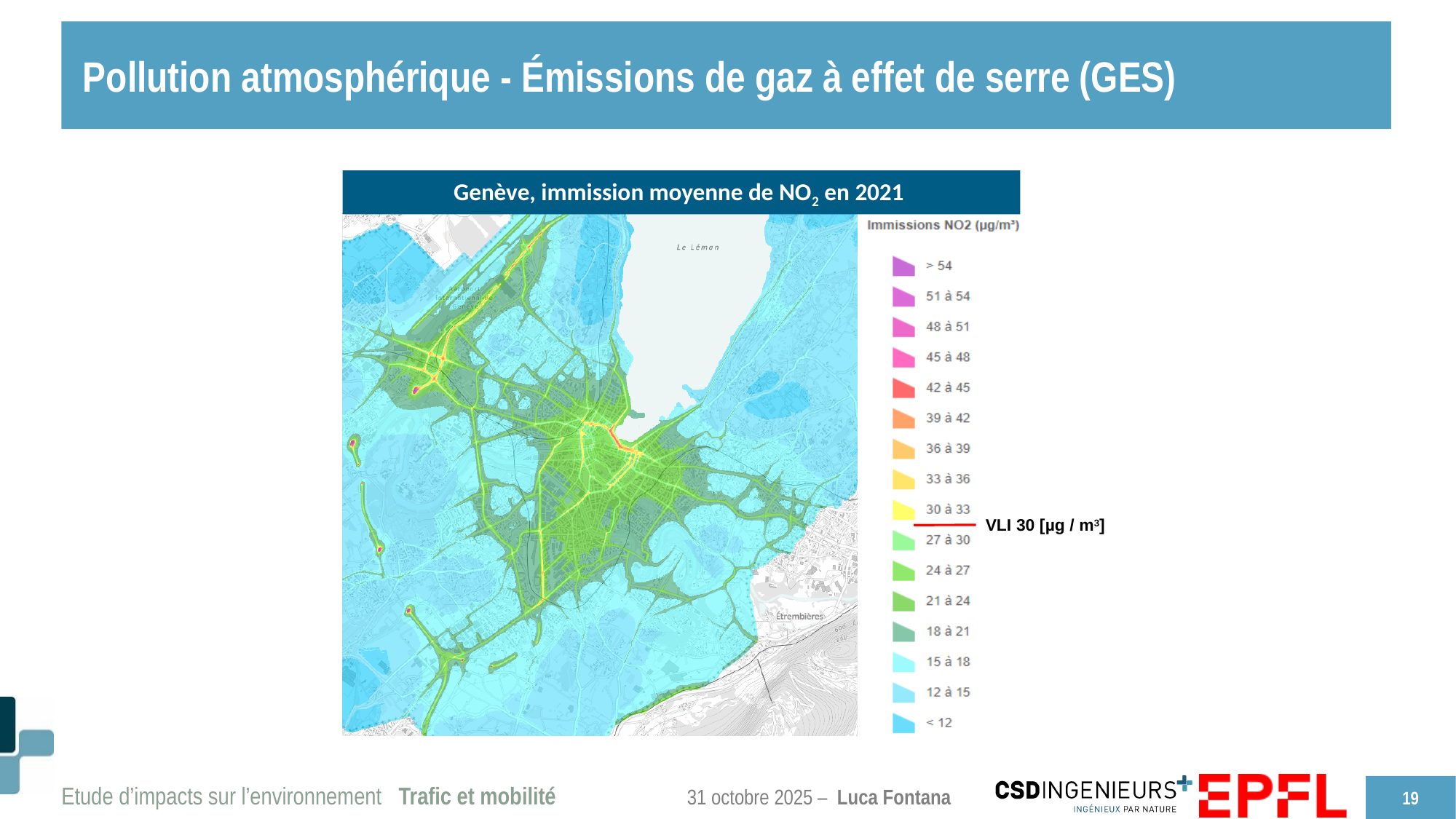
What is the highest NO2 concentration class in the map legend? > 54 What kind of chart is shown on the slide? A map Between which two legend classes is the VLI line drawn on the map legend? 30 à 33 and 27 à 30 What is the lowest NO2 concentration class in the map legend? < 12 How many NO2 concentration classes does the map legend list? 16 Which lake is labelled on the map? Le Léman What is the title of the map on the slide? Genève, immission moyenne de NO2 en 2021 What value is given for the VLI marked on the map legend? 30 µg/m³ What unit is given in the legend heading of the map? µg/m³